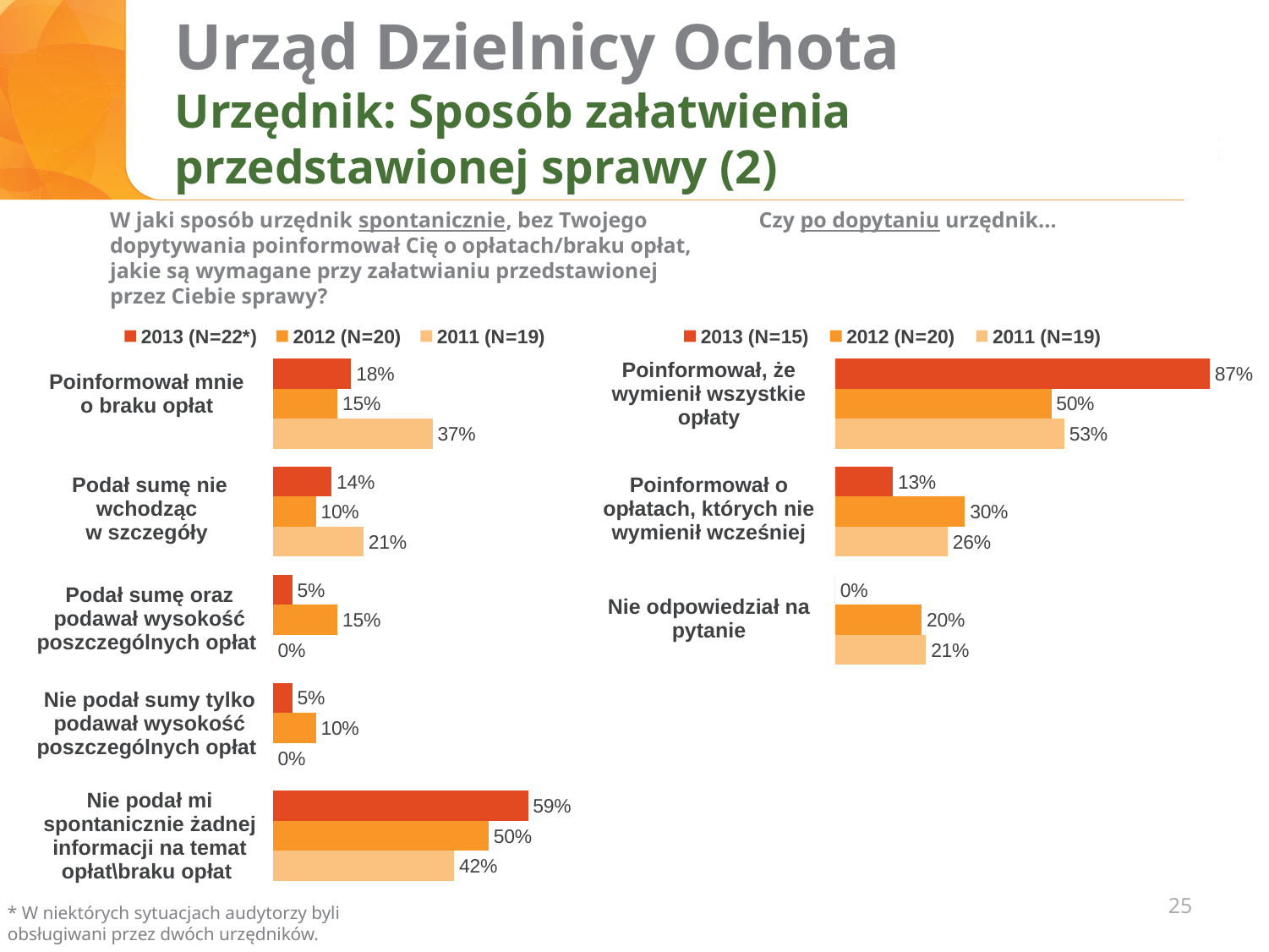
In the right chart, which category has the lowest 2013 value? Nie odpowiedział na pytanie In the left chart, which is larger for "Podał sumę oraz podawał wysokość poszczególnych opłat": the 2013 value or the 2012 value? 2012 How many categories does the left chart show? 5 In the left chart, which category has the highest 2013 value? Nie podał mi spontanicznie żadnej informacji na temat opłat\braku opłat In the left chart, what is the 2011 value for "Nie podał sumy tylko podawał wysokość poszczególnych opłat"? 0% In the left chart, what is the 2013 value for "Nie podał mi spontanicznie żadnej informacji na temat opłat\braku opłat"? 59% How many series does the legend of the right chart list? 3 In the right chart, what is the difference between the 2013 and 2012 values for "Poinformował, że wymienił wszystkie opłaty"? 37 percentage points What type of chart is the right chart? Bar chart In the right chart, what is the 2013 value for "Poinformował, że wymienił wszystkie opłaty"? 87% In the right chart, what is the 2012 value for "Poinformował o opłatach, których nie wymienił wcześniej"? 30% In the left chart, what is the 2011 value for "Poinformował mnie o braku opłat"? 37%